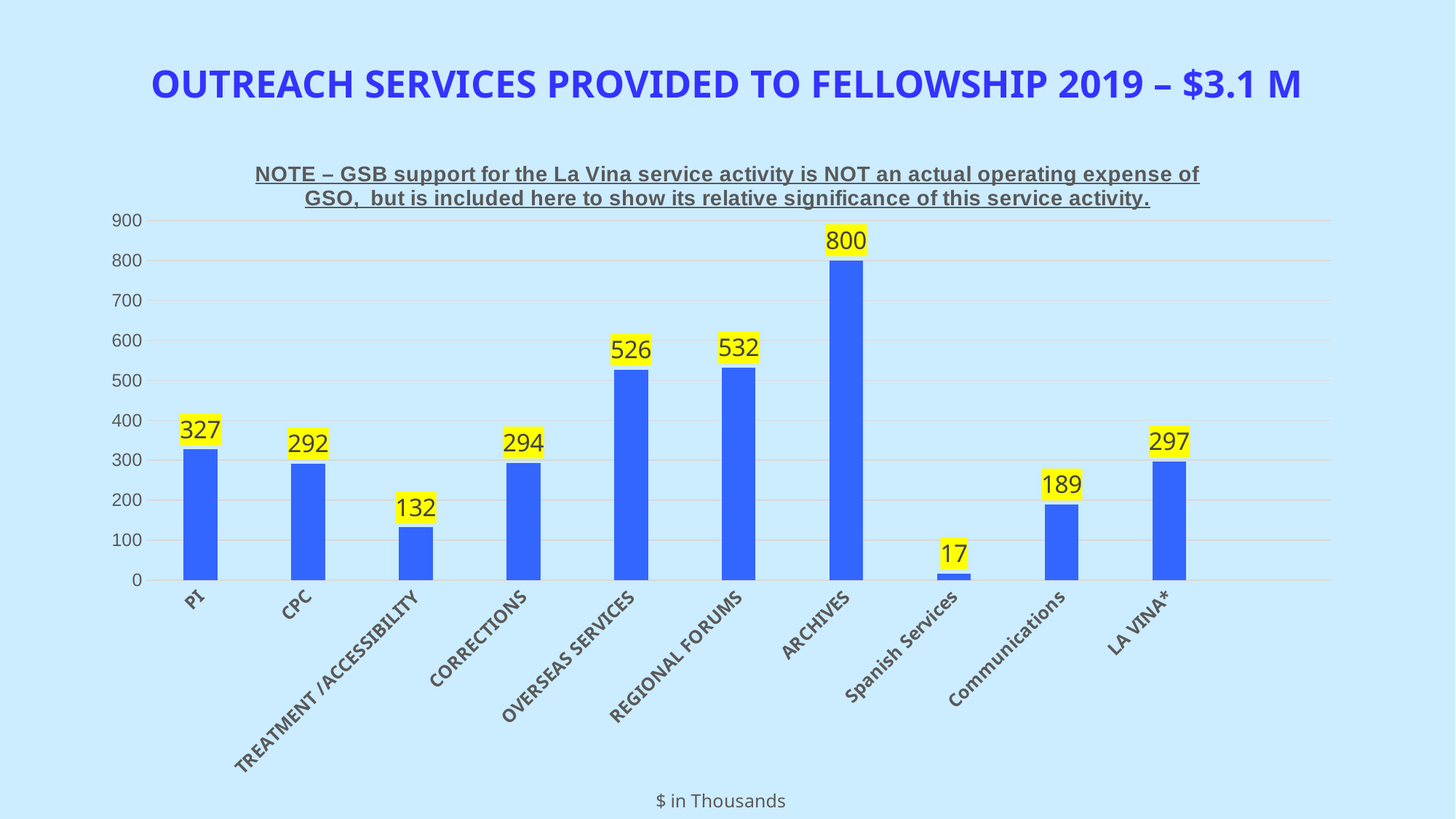
What unit is indicated below the chart? $ in Thousands What is the value for TREATMENT /ACCESSIBILITY? 132 Is the value for Communications greater or less than 200? less What is the value for Spanish Services? 17 Which category has the lowest value? Spanish Services What is the difference between the values for REGIONAL FORUMS and OVERSEAS SERVICES? 6 How many categories are shown on the x axis? 10 What is the difference between the values for ARCHIVES and Communications? 611 What is the value for ARCHIVES? 800 Which category has the highest value? ARCHIVES Which is larger, the value for PI or the value for LA VINA*? PI What kind of chart is shown on the slide? bar chart